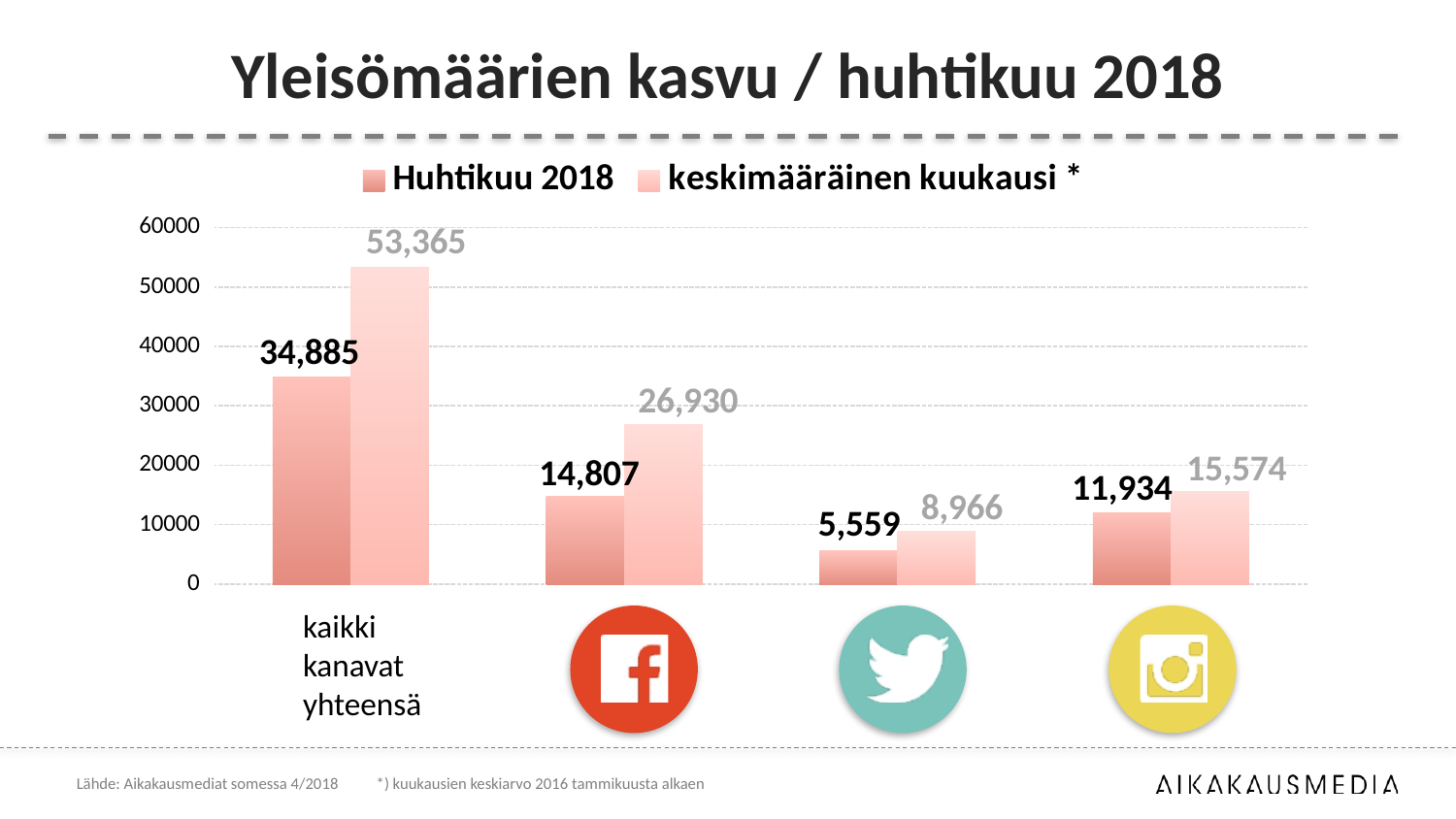
What kind of chart is shown on the slide? bar chart Which category has the lowest Huhtikuu 2018 value? Twitter What is the value for Huhtikuu 2018 in the 'kaikki kanavat yhteensä' category? 34,885 What is the Huhtikuu 2018 value for the Facebook category? 14,807 What is the value for keskimääräinen kuukausi in the 'kaikki kanavat yhteensä' category? 53,365 How many categories are shown on the x axis? 4 What is the keskimääräinen kuukausi value for the Twitter category? 8,966 What is the Huhtikuu 2018 value for the Instagram category? 11,934 What is the difference between the keskimääräinen kuukausi and Huhtikuu 2018 values for the Facebook category? 12,123 Which category has the highest keskimääräinen kuukausi value? kaikki kanavat yhteensä Which is larger for the Instagram category: the Huhtikuu 2018 value or the keskimääräinen kuukausi value? keskimääräinen kuukausi How many series does the legend list? 2